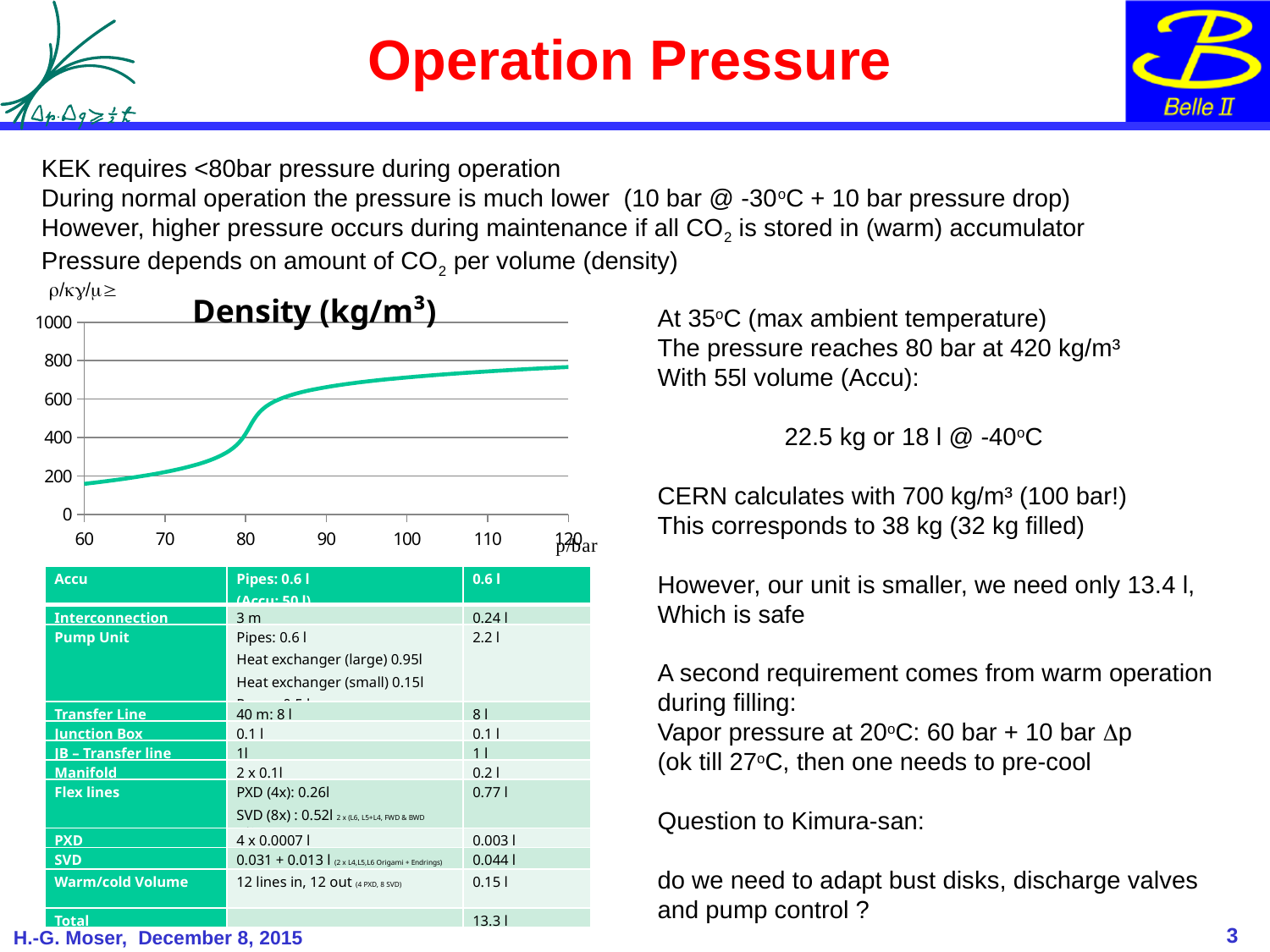
In the "Density (kg/m³)" chart, is the density at 120 bar greater or less than 600? greater In the "Density (kg/m³)" chart, is the density at 110 bar greater or less than 800? less In the "Density (kg/m³)" chart, is the density higher at 120 bar or at 60 bar? 120 bar In the "Density (kg/m³)" chart, is the density at 100 bar greater or less than 800? less In the "Density (kg/m³)" chart, do the values rise or fall as pressure increases along the x axis? rise In the "Density (kg/m³)" chart, is the density higher at 70 bar or at 90 bar? 90 bar What is the title of the chart on the slide? Density (kg/m³) What is the highest value shown on the y axis of the "Density (kg/m³)" chart? 1000 What kind of chart is the "Density (kg/m³)" chart? line chart